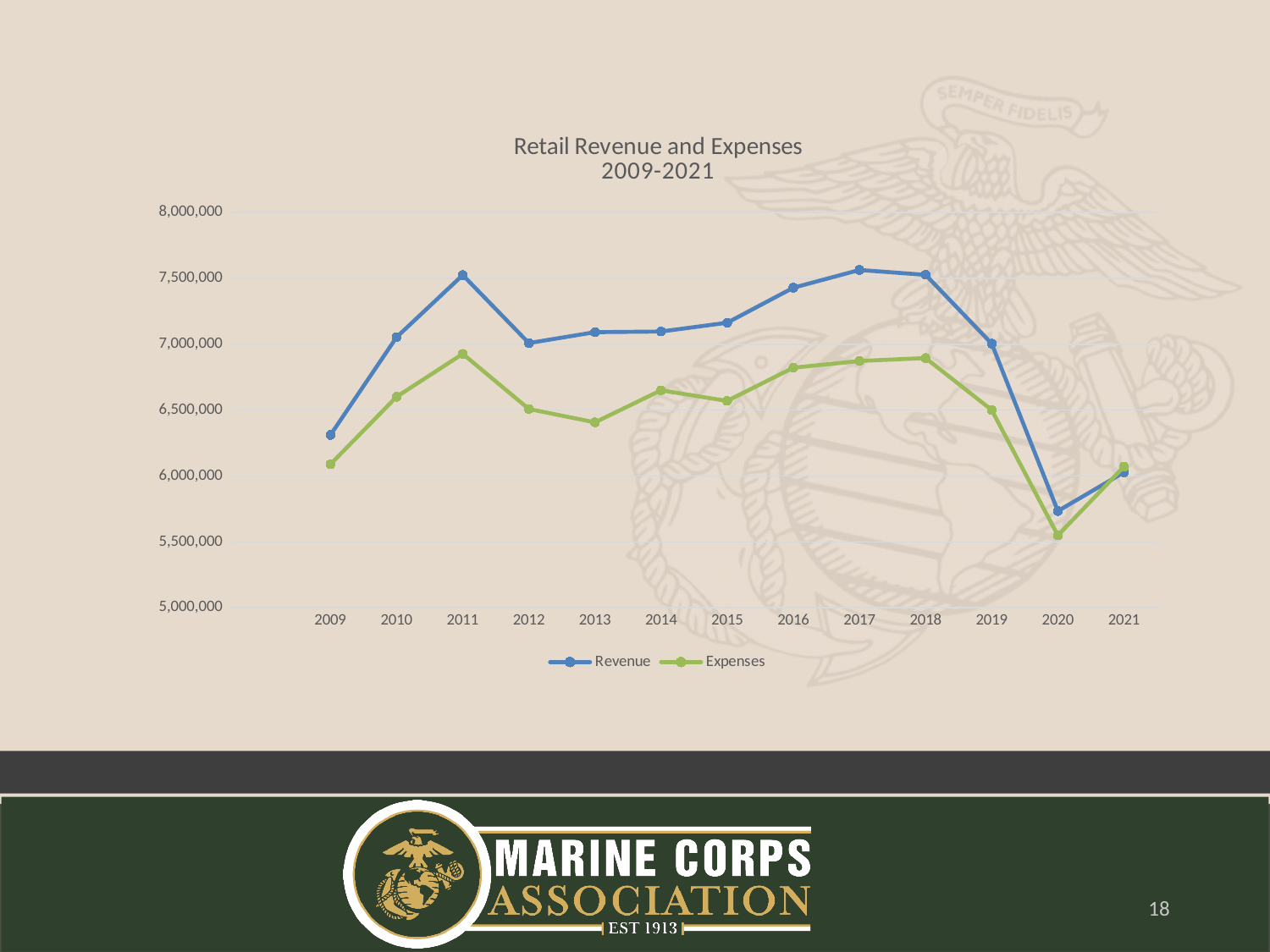
What kind of chart is shown on the slide? Line chart Does Revenue rise or fall from 2018 to 2020? Fall Is the Revenue value for 2011 greater or less than 7,000,000? greater In which year is Revenue lowest? 2020 Is the Expenses value for 2013 greater or less than 6,500,000? less How many years are plotted along the x axis? 13 In which year are Expenses lowest? 2020 Is the Revenue value for 2020 greater or less than 5,500,000? greater How many series does the legend list? 2 What is the title of the chart? Retail Revenue and Expenses 2009-2021 In 2015, which is larger, Revenue or Expenses? Revenue